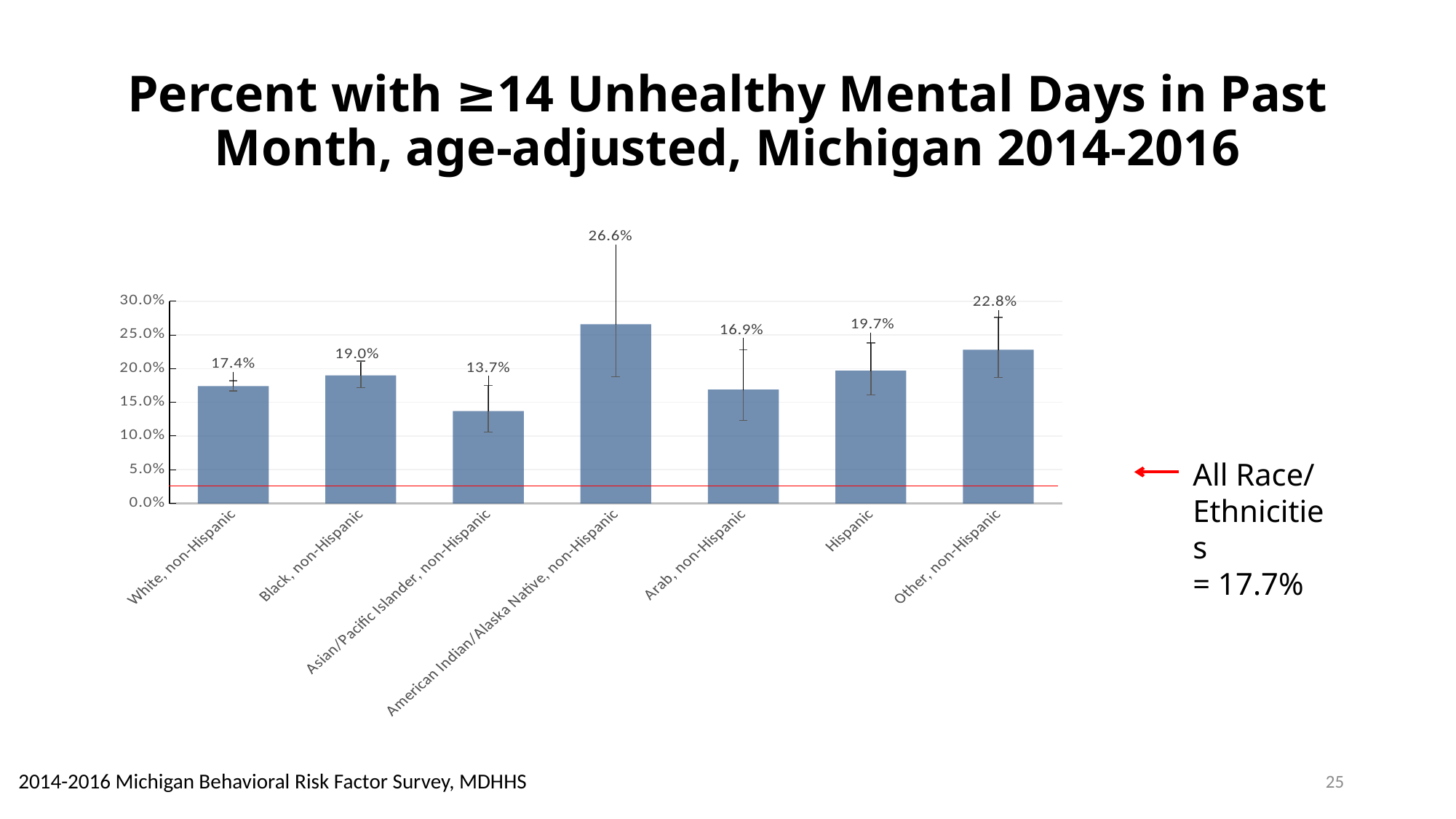
What is the value for Hispanic? 19.7% What kind of chart is shown on the slide? bar chart According to the annotation on the slide, what is the value for All Race/Ethnicities? 17.7% What is the value for Asian/Pacific Islander, non-Hispanic? 13.7% Which is larger, the value for Other, non-Hispanic or the value for Hispanic? Other, non-Hispanic Which category has the lowest value? Asian/Pacific Islander, non-Hispanic What is the difference between the values for Black, non-Hispanic and White, non-Hispanic? 1.6% How many categories are shown on the x axis? 7 Which category has the highest value? American Indian/Alaska Native, non-Hispanic What is the difference between the values for American Indian/Alaska Native, non-Hispanic and Asian/Pacific Islander, non-Hispanic? 12.9% What is the value for Other, non-Hispanic? 22.8% Is the value for Arab, non-Hispanic greater or less than 20.0%? less